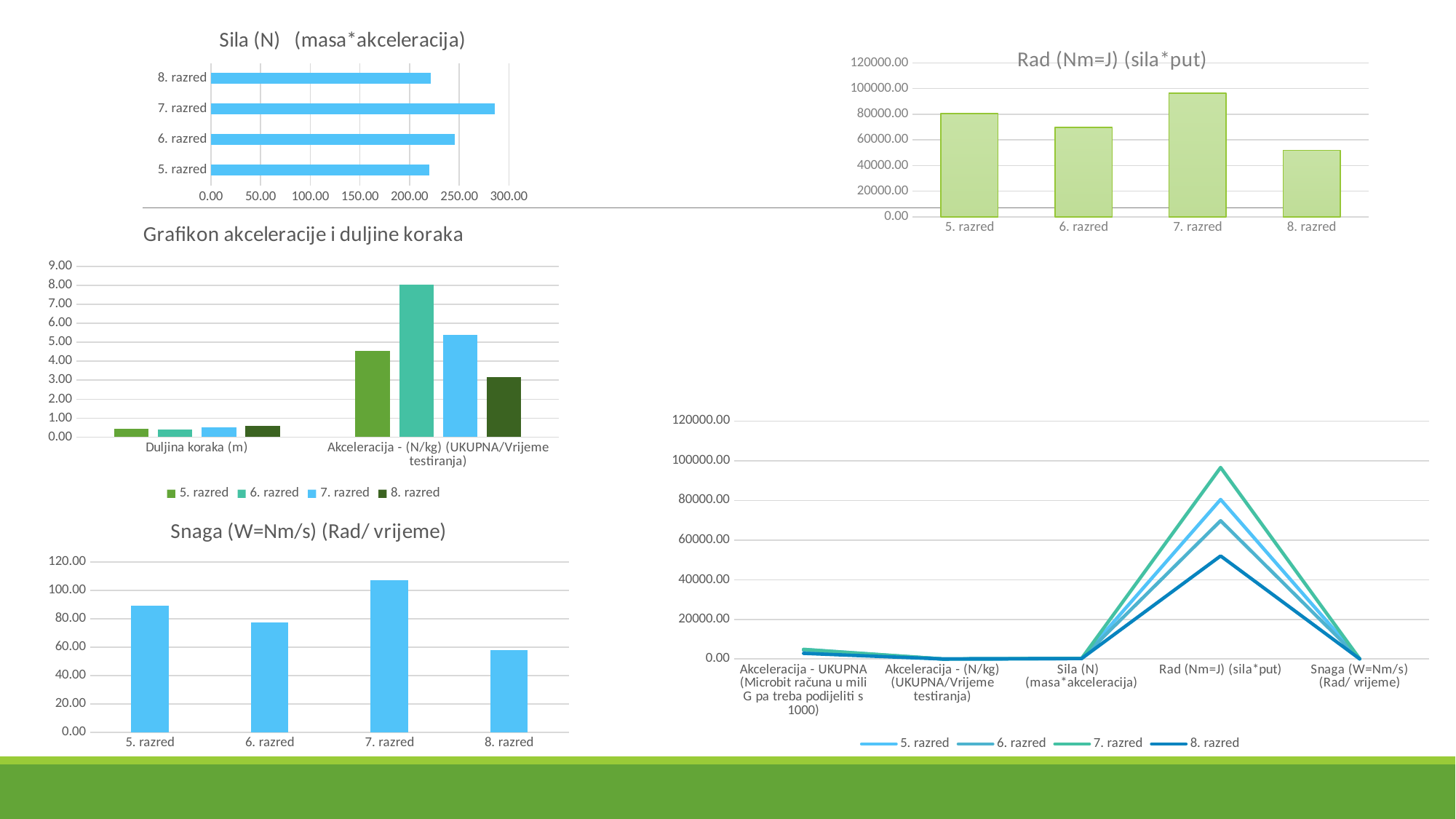
In the chart titled "Grafikon akceleracije i duljine koraka", is the Akceleracija value for 8. razred greater or less than 4.00? less In the chart titled "Grafikon akceleracije i duljine koraka", which razred has the highest Akceleracija value? 6. razred In the chart titled "Sila (N) (masa*akceleracija)", which razred has the highest value? 7. razred What kind of chart is the untitled chart in the bottom right of the slide? line chart In the chart titled "Snaga (W=Nm/s) (Rad/ vrijeme)", is the value for 7. razred greater or less than 100.00? greater In the chart titled "Grafikon akceleracije i duljine koraka", how many series does the legend list? 4 How many categories are shown on the x axis of the untitled line chart in the bottom right of the slide? 5 In the chart titled "Rad (Nm=J) (sila*put)", is the value for 8. razred greater or less than 60000.00? less In the chart titled "Rad (Nm=J) (sila*put)", which razred has the lowest value? 8. razred In the chart titled "Rad (Nm=J) (sila*put)", which is larger, the value for 5. razred or 6. razred? 5. razred In the chart titled "Snaga (W=Nm/s) (Rad/ vrijeme)", which razred has the highest value? 7. razred